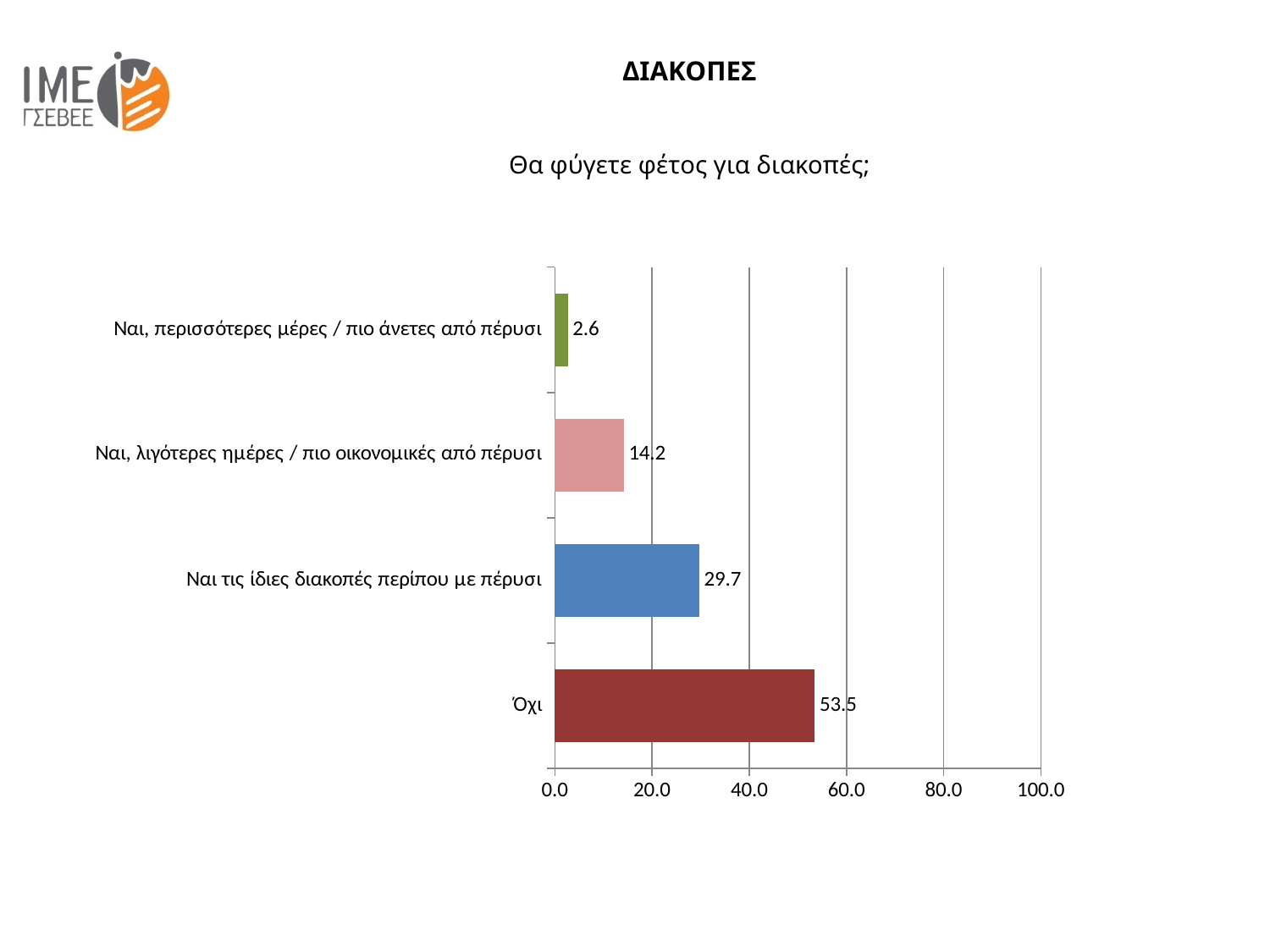
What question does the chart's subtitle ask? Θα φύγετε φέτος για διακοπές; Which category has the lowest value? Ναι, περισσότερες μέρες / πιο άνετες από πέρυσι What kind of chart is shown on the slide? bar chart What is the value for "Όχι"? 53.5 What is the value for "Ναι, λιγότερες ημέρες / πιο οικονομικές από πέρυσι"? 14.2 What is the value for "Ναι, περισσότερες μέρες / πιο άνετες από πέρυσι"? 2.6 Is the value for "Όχι" greater or less than 40.0? greater What is the difference between the values for "Όχι" and "Ναι τις ίδιες διακοπές περίπου με πέρυσι"? 23.8 Which is larger: the value for "Ναι, λιγότερες ημέρες / πιο οικονομικές από πέρυσι" or for "Ναι τις ίδιες διακοπές περίπου με πέρυσι"? Ναι τις ίδιες διακοπές περίπου με πέρυσι Which category has the highest value? Όχι What is the value for "Ναι τις ίδιες διακοπές περίπου με πέρυσι"? 29.7 How many categories are shown in the chart? 4